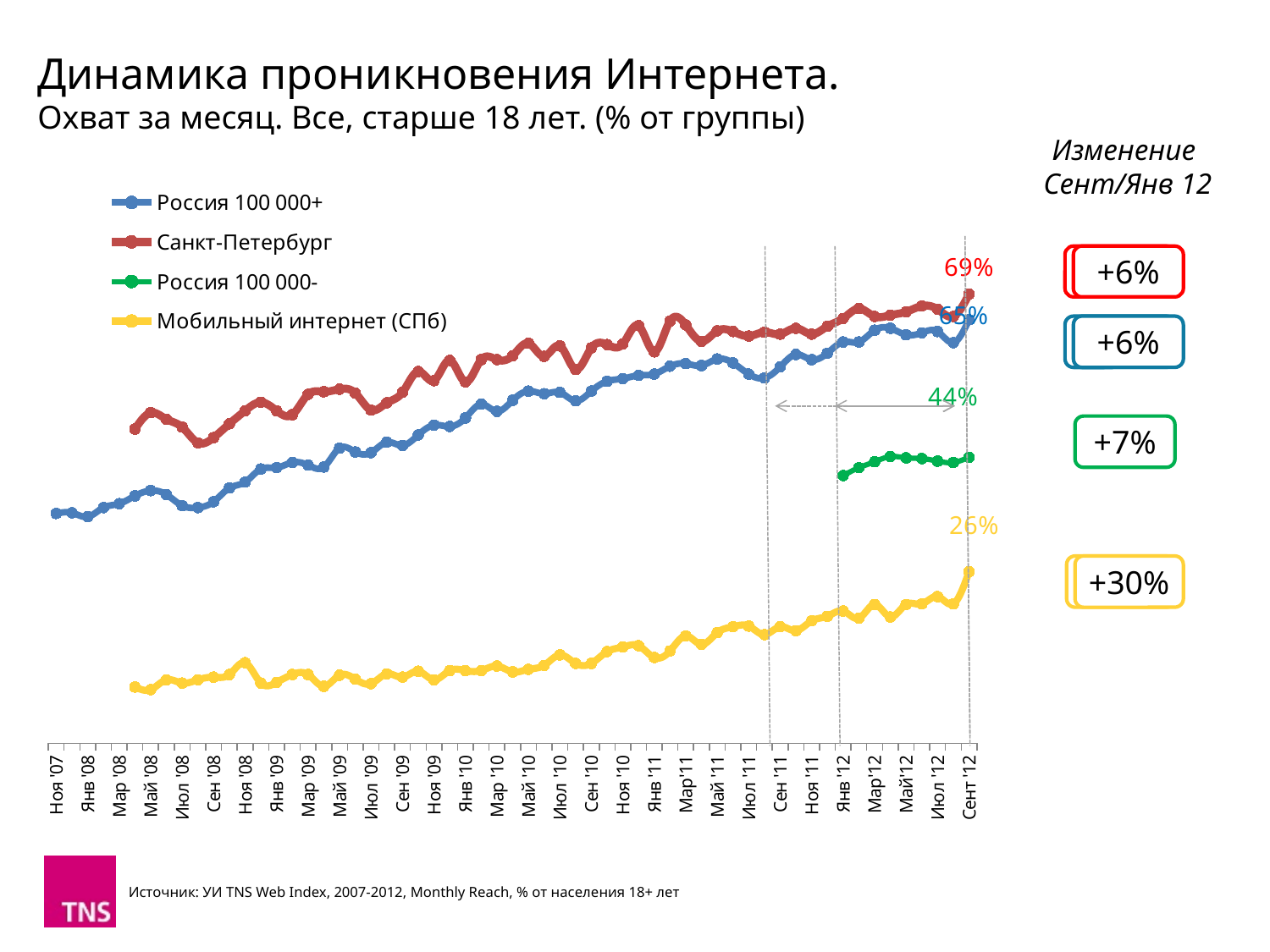
Which series has the lowest value at Сент '12? Мобильный интернет (СПб) Does the Мобильный интернет (СПб) line generally rise or fall from Мар '08 to Сент '12? rise What kind of chart is shown on the slide? line chart What is the value for Россия 100 000- at Сент '12? 44% What change (Изменение Сент/Янв 12) is shown for Мобильный интернет (СПб)? +30% At Сент '12, which is larger: Россия 100 000- or Мобильный интернет (СПб)? Россия 100 000- What change (Изменение Сент/Янв 12) is shown for Россия 100 000-? +7% What is the value for Санкт-Петербург at Сент '12? 69% Which series has the highest value at Сент '12? Санкт-Петербург What is the value for Мобильный интернет (СПб) at Сент '12? 26% How many series does the legend list? 4 What is the difference between the Санкт-Петербург value and the Россия 100 000- value at Сент '12? 25 percentage points